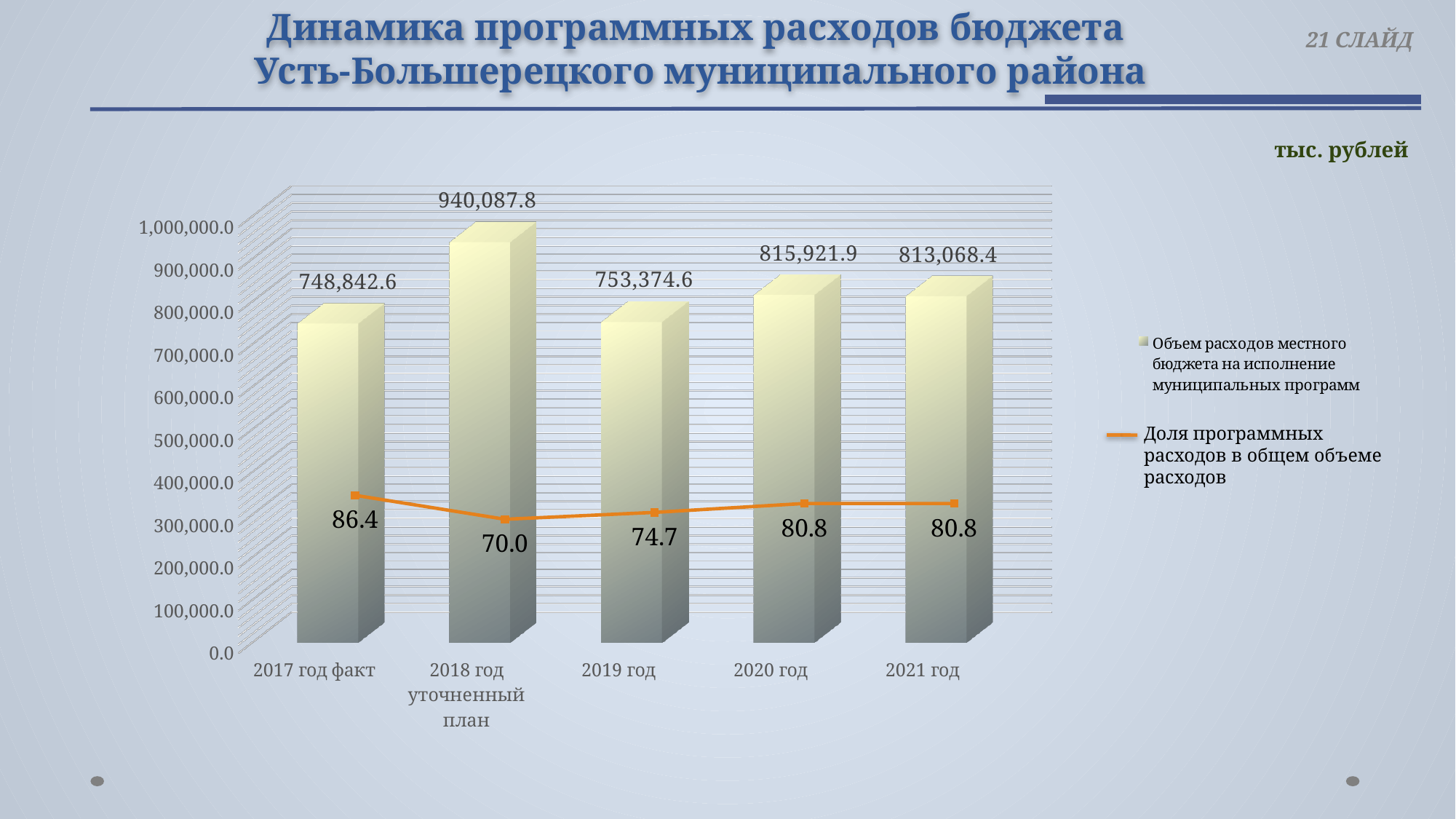
What is the difference between the bar values for 2018 год уточненный план and 2017 год факт? 191,245.2 What unit is stated above the chart? тыс. рублей How many categories are shown on the x axis? 5 What is the difference between the line values for 2017 год факт and 2018 год уточненный план? 16.4 What is the value of the line series (Доля программных расходов в общем объеме расходов) for 2019 год? 74.7 Which bar is larger, 2020 год or 2019 год? 2020 год Which category has the lowest value on the line series? 2018 год уточненный план How many series does the legend list? 2 What is the value of the bar for 2018 год уточненный план? 940,087.8 Which category has the lowest bar value? 2017 год факт Which category has the highest bar value? 2018 год уточненный план What is the value of the bar for 2017 год факт? 748,842.6